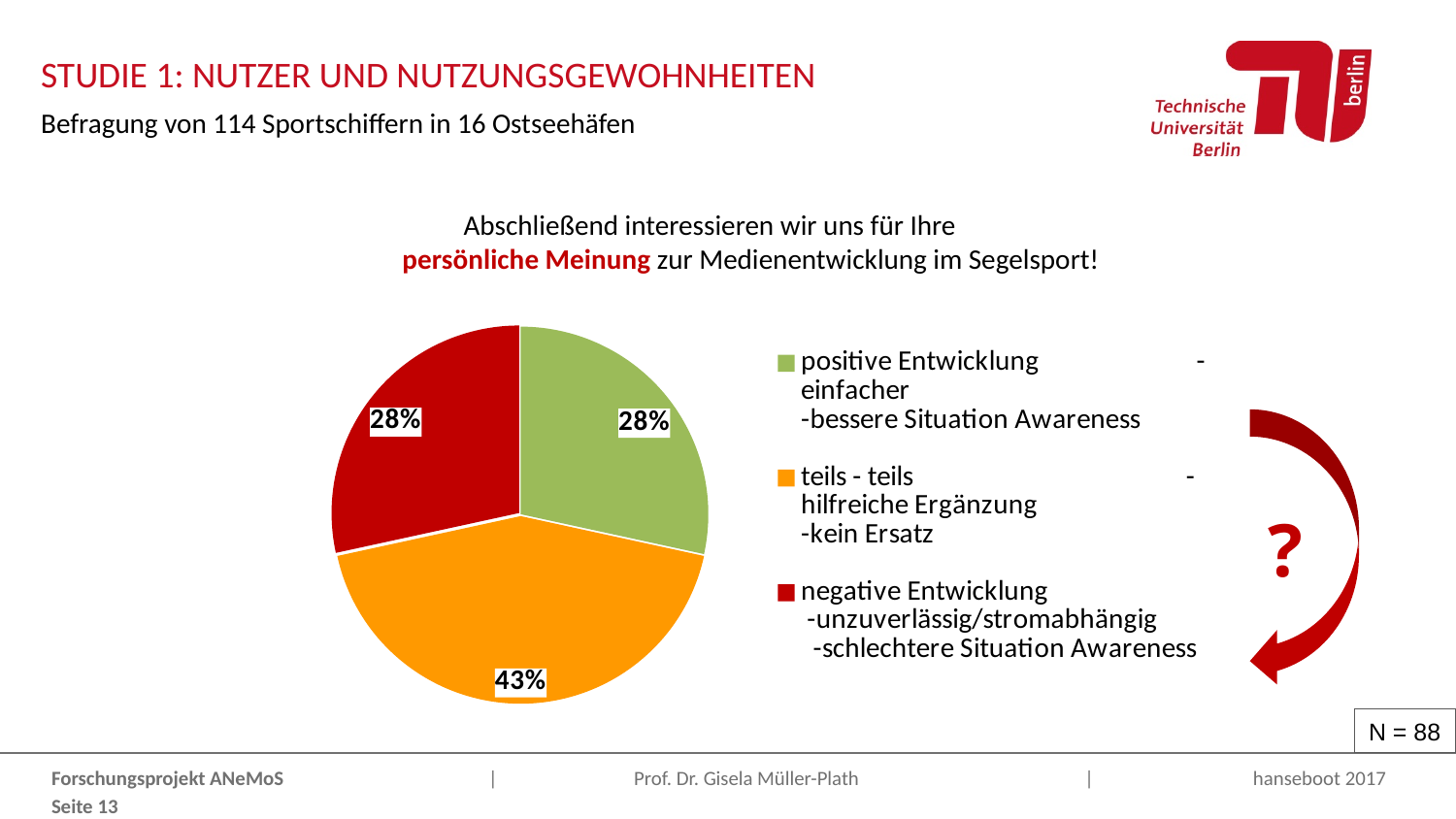
Which colour represents "negative Entwicklung" in the pie chart? red What share of the pie does "positive Entwicklung" take? 28% Which colour represents "teils - teils" in the pie chart? orange What share of the pie does "teils - teils" take? 43% What share of the pie does "negative Entwicklung" take? 28% What kind of chart is shown on the slide? pie chart What is the combined share of "positive Entwicklung" and "negative Entwicklung"? 56% Which is larger, the slice for "teils - teils" or the slice for "negative Entwicklung"? teils - teils What is the difference in percentage points between "teils - teils" and "positive Entwicklung"? 15 How many entries does the legend list? 3 How many slices does the pie chart have? 3 Which category has the largest slice of the pie? teils - teils